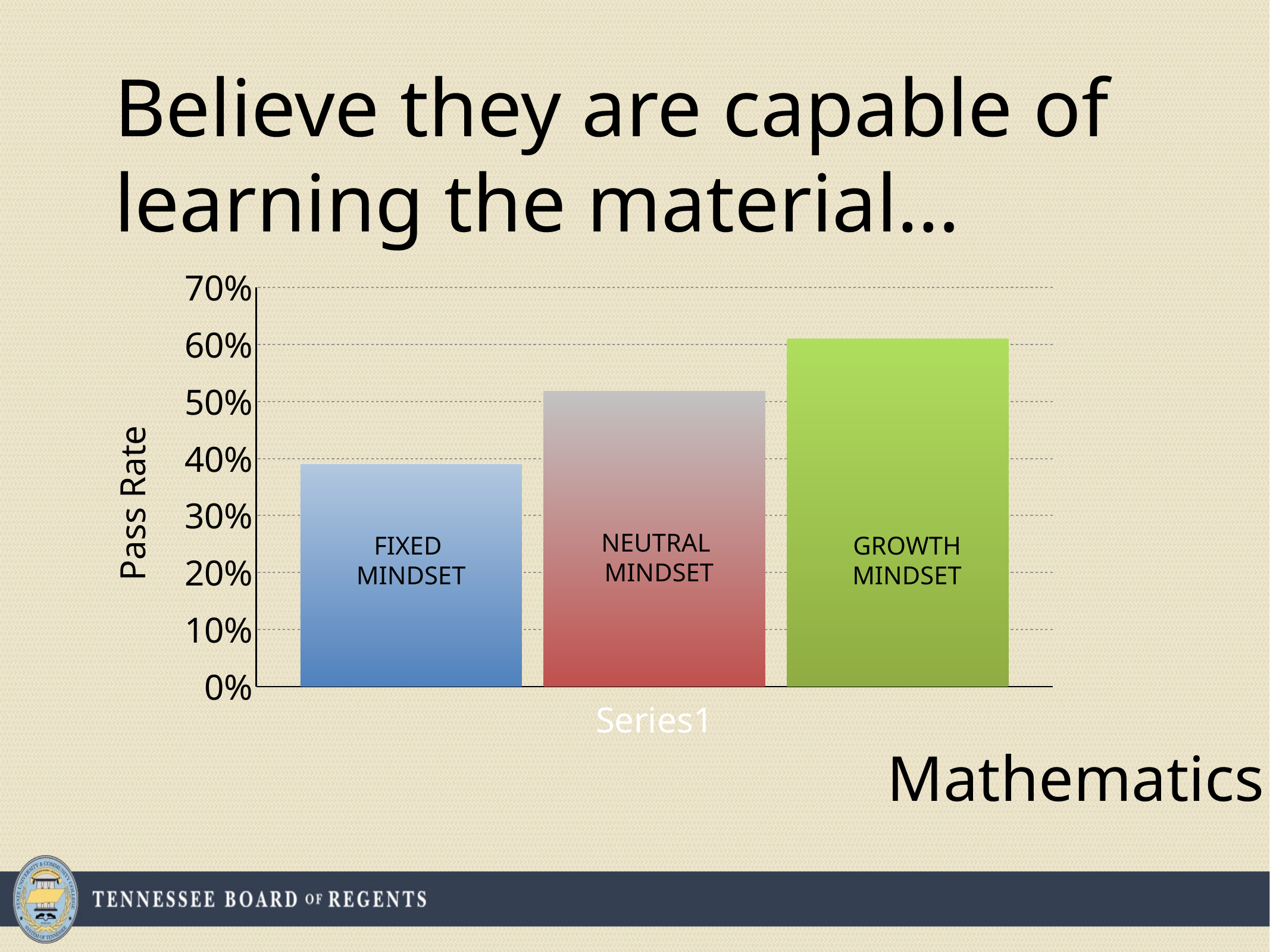
Is the pass rate for Fixed Mindset greater or less than 30%? greater Which has a higher pass rate, Neutral Mindset or Fixed Mindset? Neutral Mindset Is the pass rate for Neutral Mindset greater or less than 40%? greater Which has a higher pass rate, Growth Mindset or Neutral Mindset? Growth Mindset Which mindset group has the lowest pass rate? Fixed Mindset Which mindset group has the highest pass rate? Growth Mindset Do the pass rates rise or fall moving from Fixed Mindset to Growth Mindset along the x axis? rise What colour is the Growth Mindset bar? green What is the title of the vertical axis? Pass Rate How many bars are plotted in the chart? 3 What kind of chart is shown on the slide? bar chart Is the pass rate for Growth Mindset greater or less than 70%? less